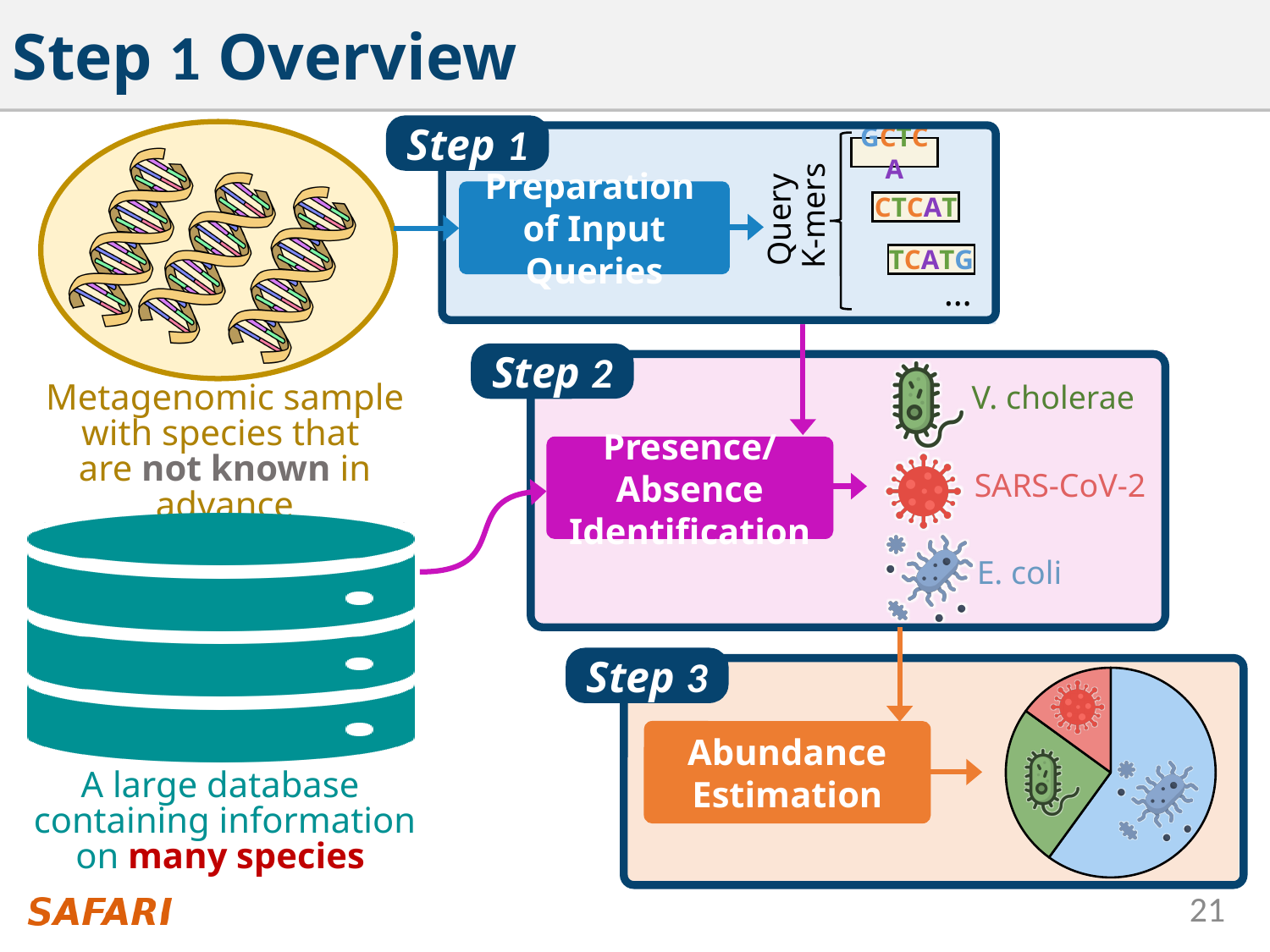
What is the label of the box that points to the pie chart in Step 3? Abundance Estimation In the pie chart in the Step 3 box, is the blue slice or the red slice larger? blue Which step's box on the slide contains the pie chart? Step 3 In the pie chart in the Step 3 box, is the blue slice or the green slice larger? blue Which colour slice is the largest in the pie chart in the Step 3 box? blue What kind of chart is shown in the Step 3 box? pie chart How many slices does the pie chart in the Step 3 box have? 3